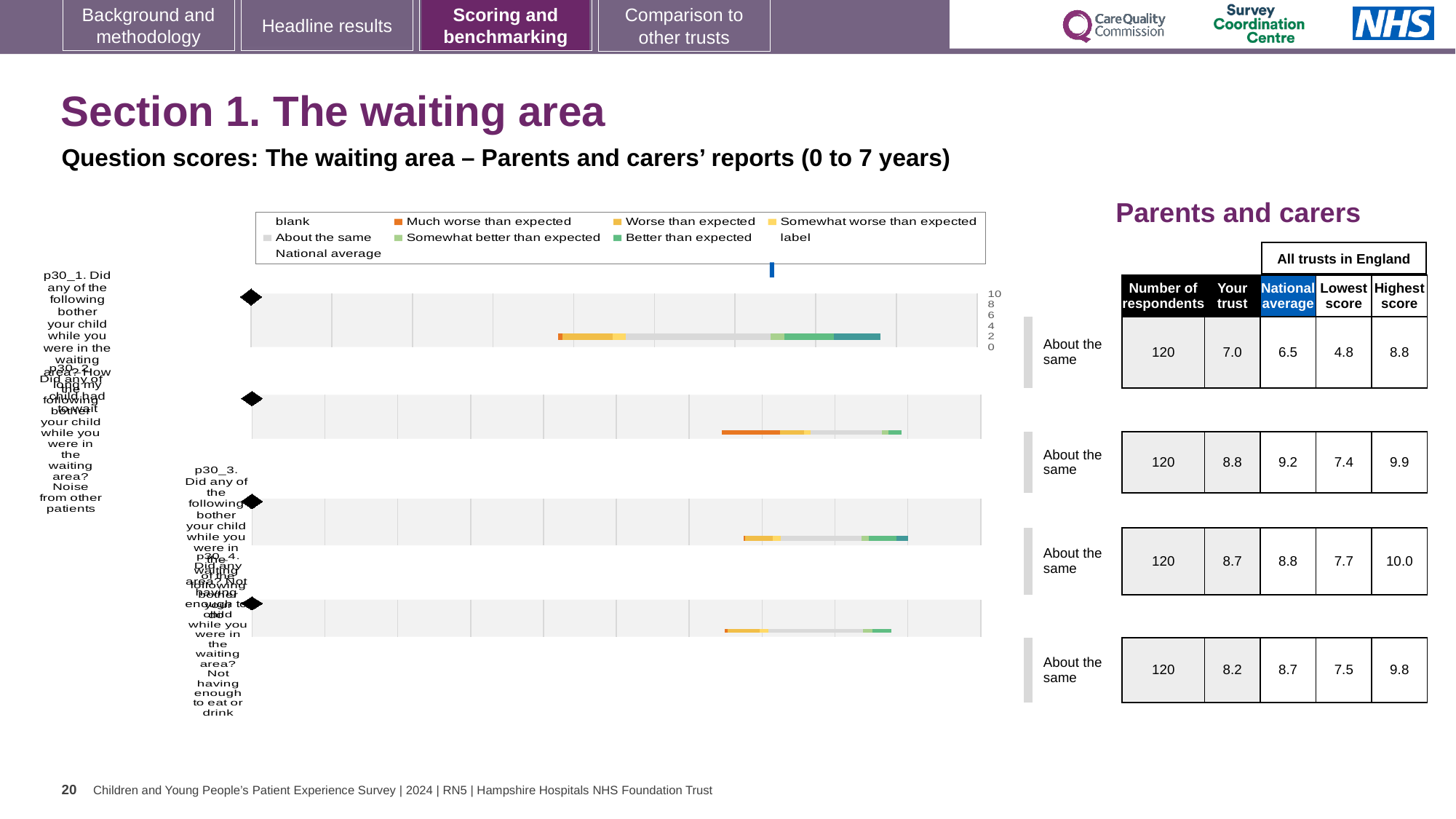
What is the highest score across all trusts in England for the third question (p30_3)? 10.0 What benchmark category is shown next to each of the four question bars? About the same How many respondents are shown for each question in the table? 120 What kind of chart is shown on the slide? Bar chart Which question has the highest 'Your trust' score? p30_2 (noise from other patients), 8.8 What colour does the legend use for 'Much worse than expected'? Orange What is the national average score for the second question (p30_2, noise from other patients)? 9.2 For the first question (p30_1), what is the difference between the 'Your trust' score and the national average? 0.5 Which question has the lowest 'Your trust' score? p30_1 (how long my child had to wait), 7.0 How many question bars are plotted in the chart? 4 For the third question (p30_3, not having enough to do), which is larger: the 'Your trust' score or the national average? National average (8.8) What is the 'Your trust' score for the first question (p30_1, how long my child had to wait)? 7.0